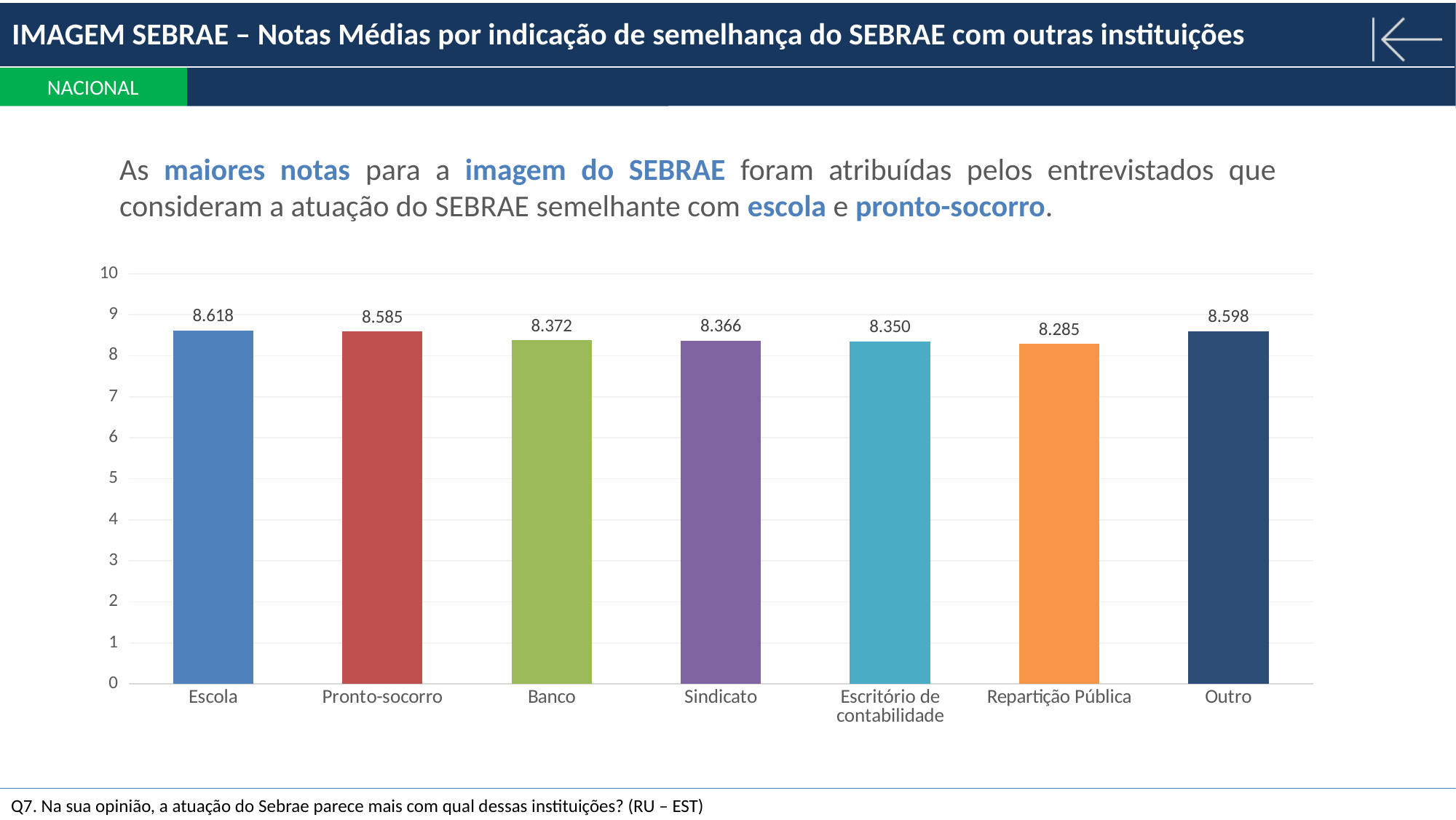
What is the average score for Escritório de contabilidade? 8.350 What is the difference between the scores for Escola and Repartição Pública? 0.333 What kind of chart is shown on the slide? bar chart What is the average score for Outro? 8.598 How many categories are shown in the chart? 7 Which has a higher score, Pronto-socorro or Sindicato? Pronto-socorro Is the value for Banco greater or less than 9? less What is the average score for Repartição Pública? 8.285 What is the average score for Escola? 8.618 What is the difference between the scores for Outro and Banco? 0.226 Which category has the lowest average score? Repartição Pública Which category has the highest average score? Escola